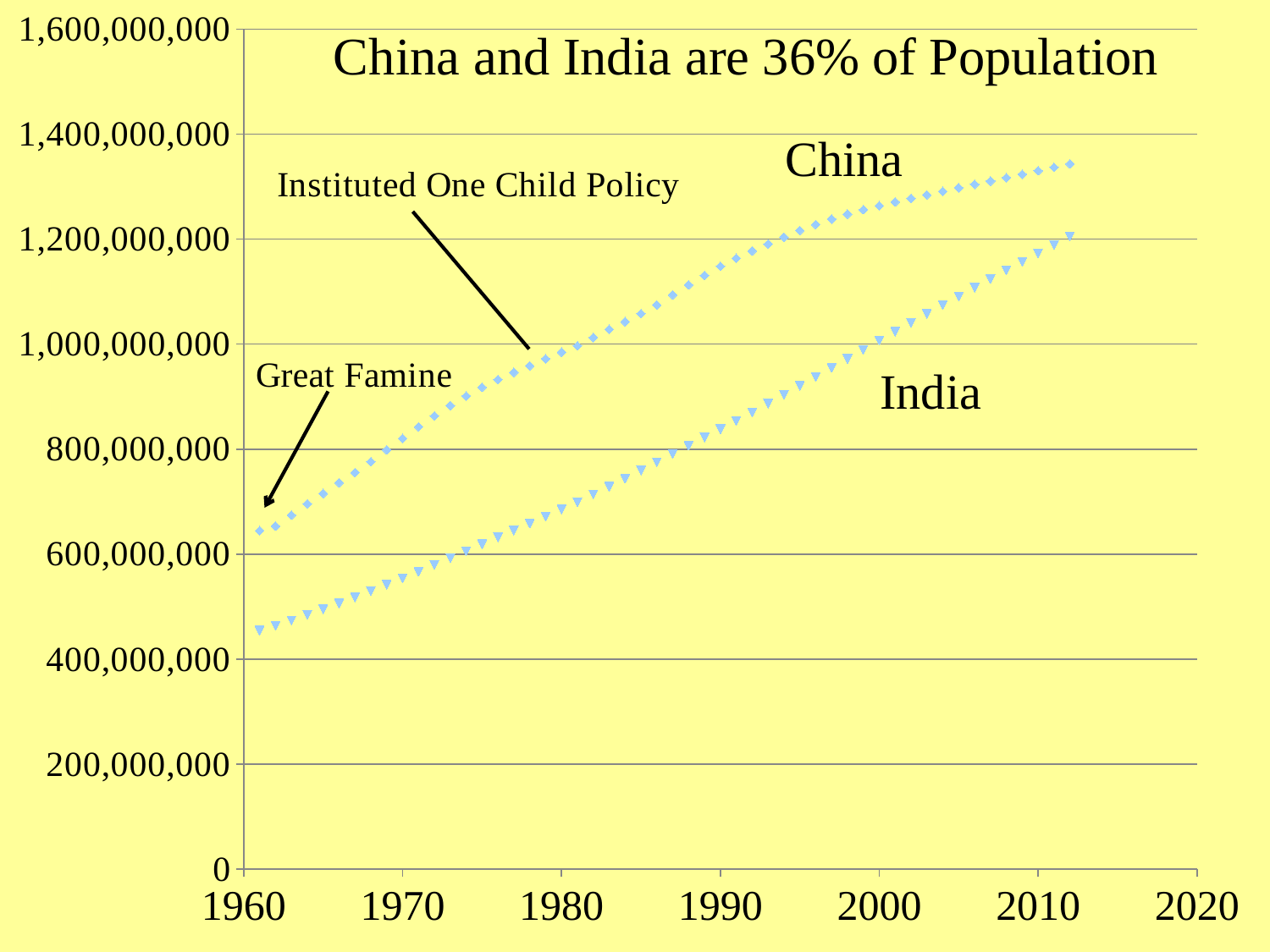
Is the value for India in 1990 greater or less than 800,000,000? greater Is the value for China in 1990 greater or less than 1,000,000,000? greater Is the value for India in 1960 greater or less than 600,000,000? less Does the population of India rise or fall from 1960 to 2010? rise Which event is annotated on the China series around 1980? Instituted One Child Policy How many series are plotted on the chart? 2 Which series has the higher population in 2010, China or India? China Which series has the higher population in 1960, China or India? China Does the population of China rise or fall from 1960 to 2010? rise What is the title of the chart? China and India are 36% of Population